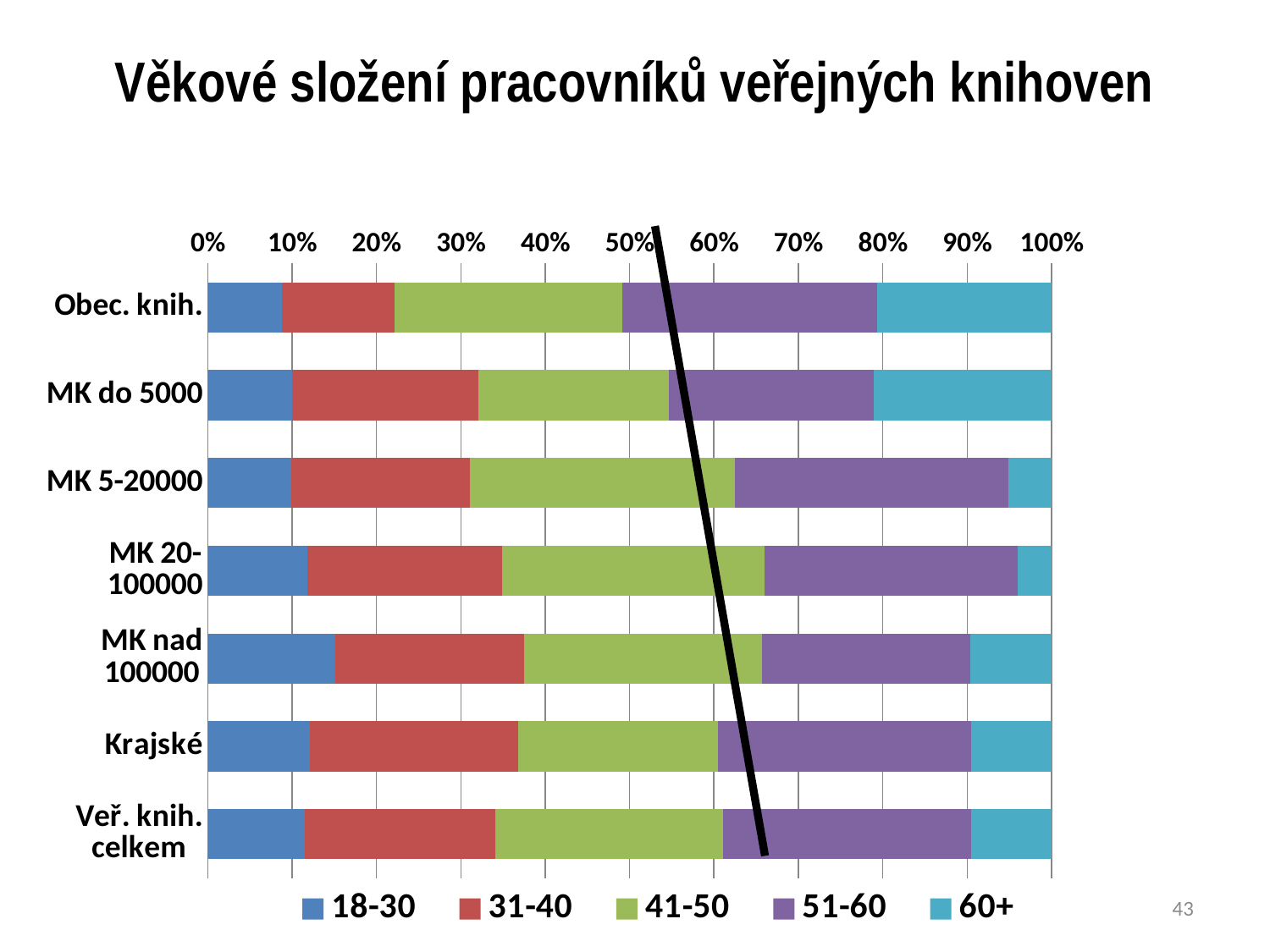
Which has the larger 60+ share, MK do 5000 or MK 20-100000? MK do 5000 Is the 18-30 share for Krajské greater or less than 10%? greater Which library category has the largest 18-30 share? MK nad 100000 Which age group does the legend list last? 60+ Which has the larger 60+ share, Obec. knih. or MK 5-20000? Obec. knih. Is the 18-30 share for MK nad 100000 greater or less than 10%? greater Is the 18-30 share for Obec. knih. greater or less than 10%? less What is the title of the chart? Věkové složení pracovníků veřejných knihoven Which has the larger 18-30 share, MK nad 100000 or Obec. knih.? MK nad 100000 How many library categories are plotted on the y axis? 7 What kind of chart is shown on the slide? bar chart How many age-group series does the legend list? 5